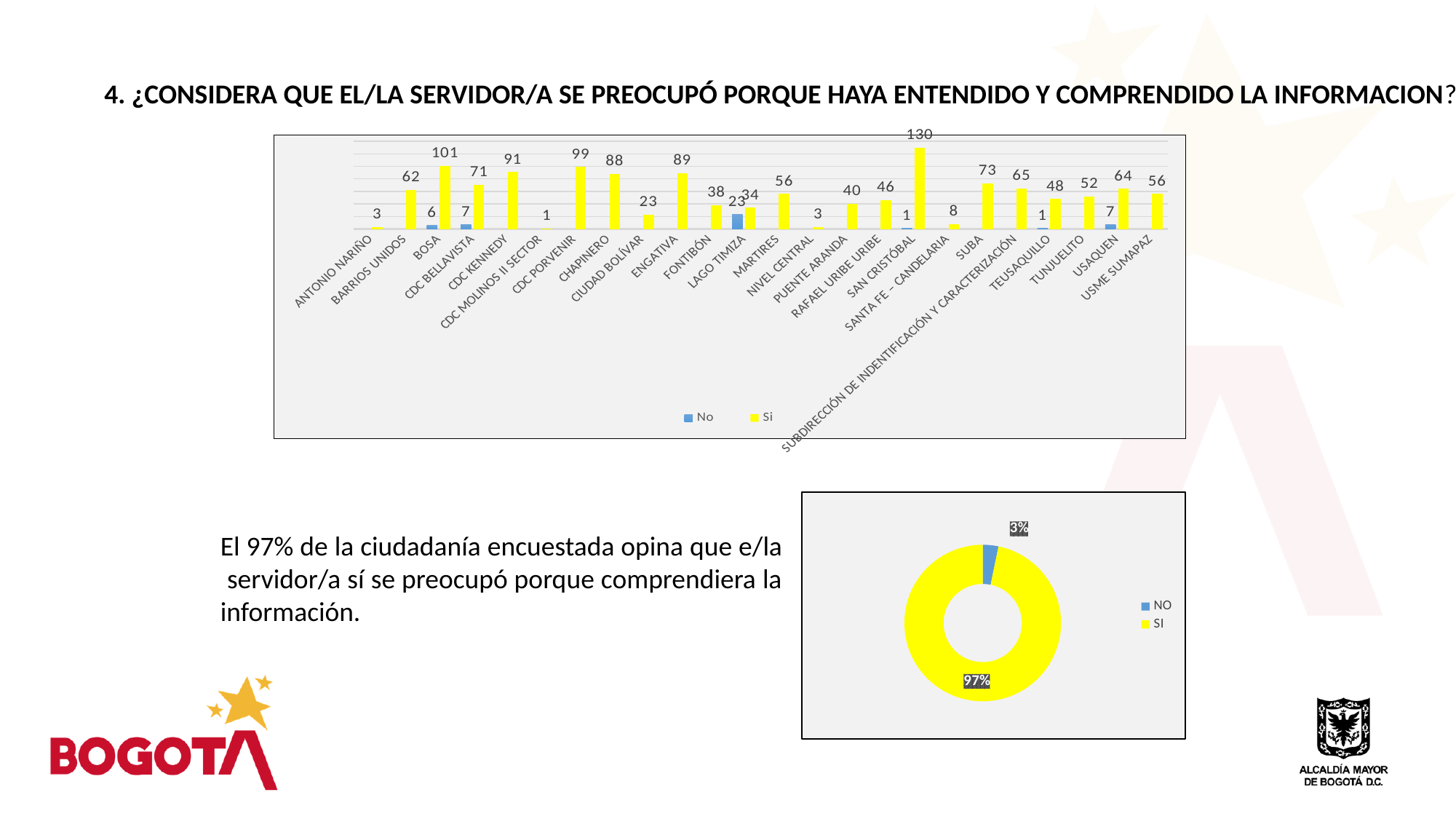
In the pie chart, what share does SI have? 97% How many categories are shown on the x axis of the bar chart? 24 In the bar chart, what is the Si value for SAN CRISTÓBAL? 130 What kind of chart is the chart at the top of the slide? bar chart In the bar chart, which category has the highest Si value? SAN CRISTÓBAL In the bar chart, what is the No value for LAGO TIMIZA? 23 In the bar chart, what is the Si value for CDC KENNEDY? 91 How many series does the legend of the bar chart list? 2 In the bar chart, what is the difference between the Si values for BOSA and CDC PORVENIR? 2 In the bar chart, which has a larger Si value, CHAPINERO or ENGATIVA? ENGATIVA In the bar chart, which has a larger Si value, SUBA or TEUSAQUILLO? SUBA In the pie chart, what share does NO have? 3%